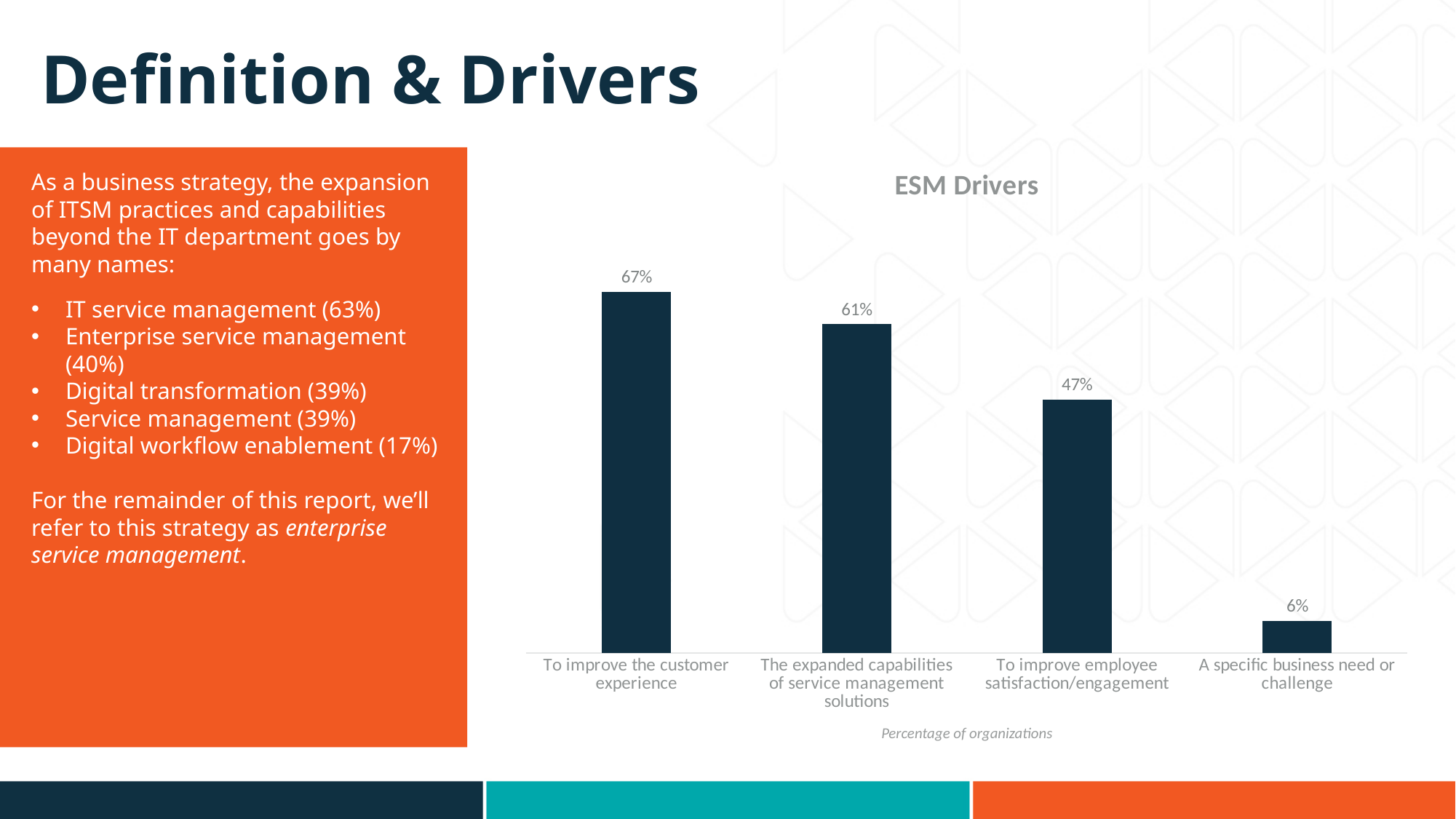
What is the value for 'To improve employee satisfaction/engagement'? 47% Which driver has the highest value in the ESM Drivers chart? To improve the customer experience What is the difference between 'The expanded capabilities of service management solutions' and 'A specific business need or challenge'? 55% What kind of chart is the ESM Drivers chart? Bar chart Do the values rise or fall from left to right across the ESM Drivers chart? Fall What is the value for 'To improve the customer experience' in the ESM Drivers chart? 67% What is the value for 'The expanded capabilities of service management solutions'? 61% How many categories are shown in the ESM Drivers chart? 4 What is the value for 'A specific business need or challenge'? 6% What is the difference between 'To improve the customer experience' and 'To improve employee satisfaction/engagement'? 20% Which is larger: 'The expanded capabilities of service management solutions' or 'To improve employee satisfaction/engagement'? The expanded capabilities of service management solutions Which driver has the lowest value in the ESM Drivers chart? A specific business need or challenge